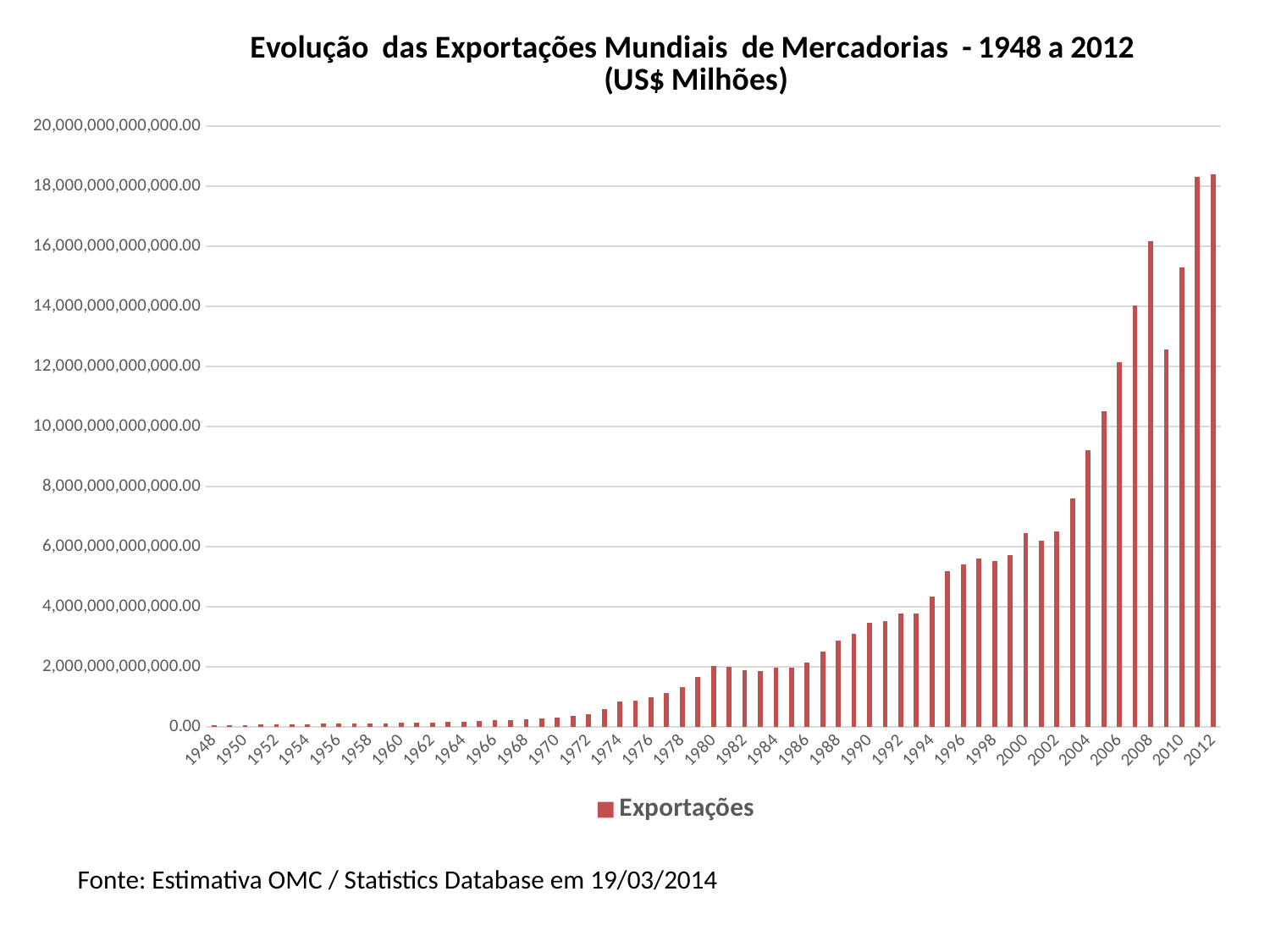
What kind of chart is shown on the slide? Bar chart What is the title of the chart? Evolução das Exportações Mundiais de Mercadorias - 1948 a 2012 (US$ Milhões) Is the value for 1990 greater or less than 4,000,000,000,000.00? less Is the value for 2009 greater or less than 12,000,000,000,000.00? greater Which year has the larger export value, 2008 or 2009? 2008 How many series does the legend list? 1 Do the export values generally rise or fall from 1948 to 2012? Rise Which year has the larger export value, 2004 or 2005? 2005 What is the name of the series shown in the legend? Exportações Is the value for 2010 greater or less than 16,000,000,000,000.00? less